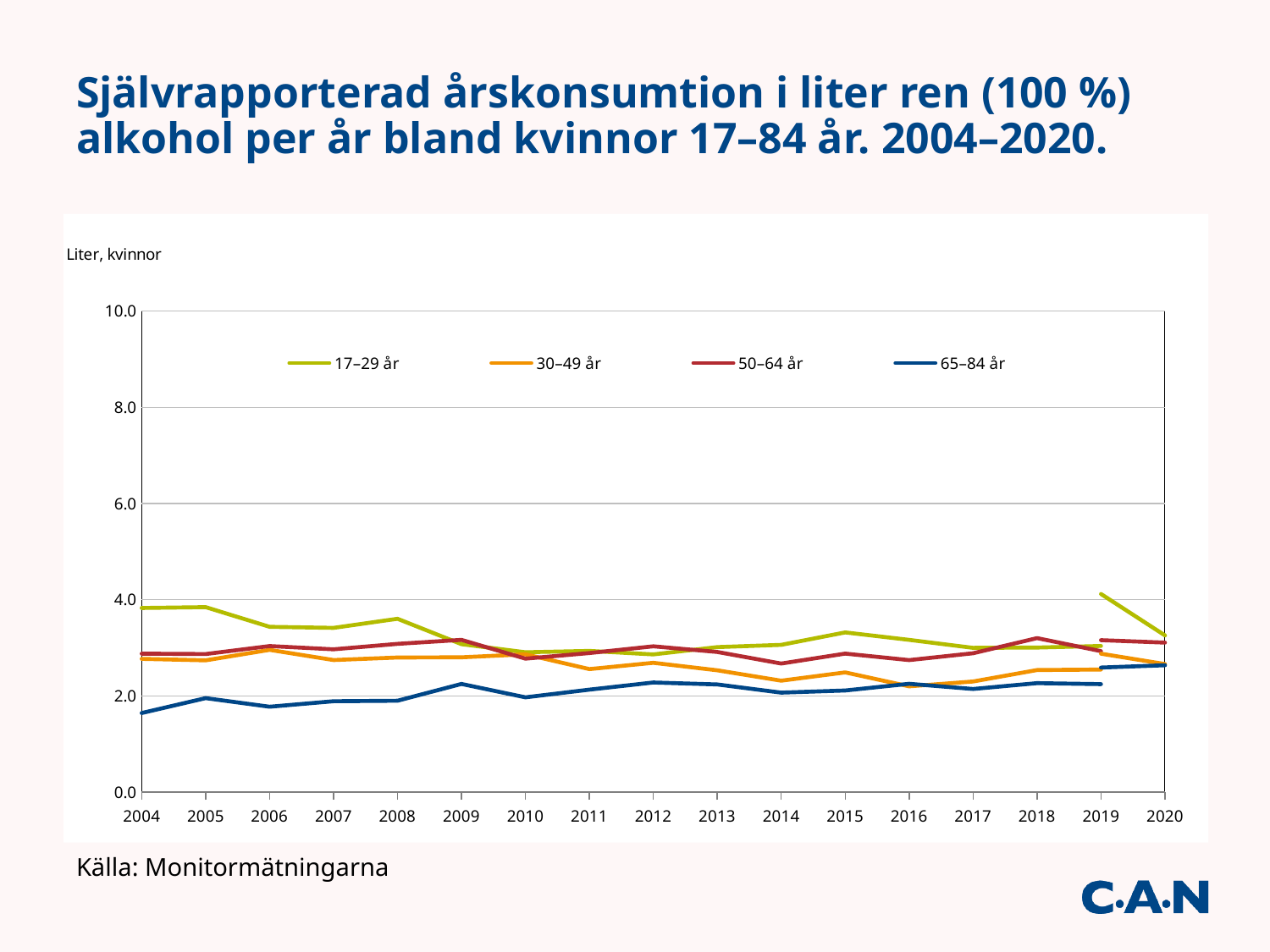
Is the value for 50–64 år in 2018 greater or less than 2.0? greater How many years are plotted along the x axis? 17 What kind of chart is shown on the slide? line chart How many series does the legend list? 4 Is the value for 17–29 år in 2004 greater or less than 4.0? less In 2018, which is larger: the value for 50–64 år or the value for 30–49 år? 50–64 år What is the label shown above the y axis of the chart? Liter, kvinnor Which age group has the highest value in 2008? 17–29 år Is the value for 65–84 år in 2004 greater or less than 2.0? less Which age group has the lowest value in 2004? 65–84 år Does the value for 65–84 år rise or fall overall from 2004 to 2020? rise Which age group has the highest value in 2004? 17–29 år